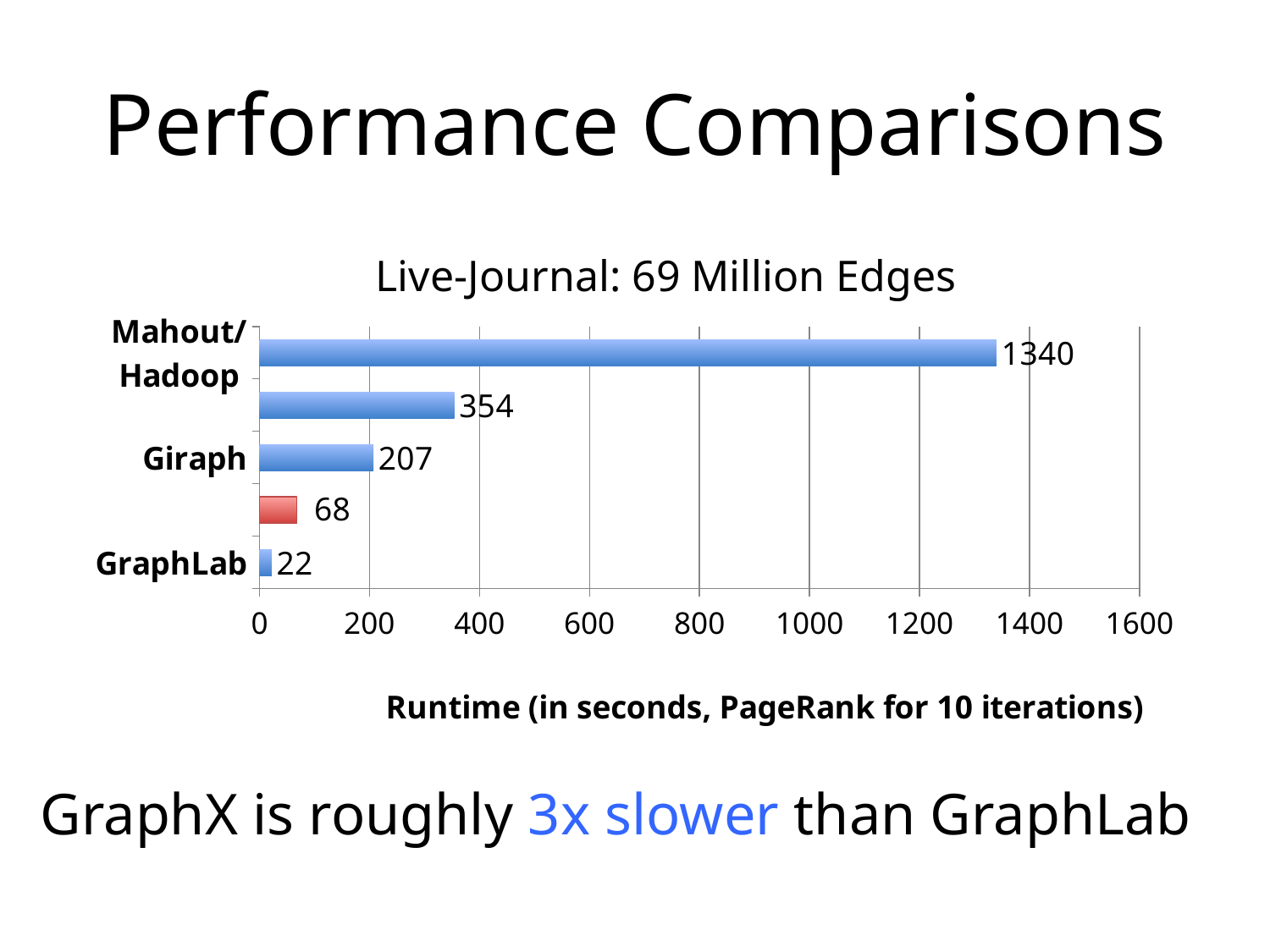
What kind of chart is shown on the slide? bar chart What is the difference in runtime between Giraph and GraphLab? 185 What is the difference in runtime between Mahout/Hadoop and Giraph? 1133 How many bars are plotted in the chart? 5 What is the runtime for Mahout/Hadoop? 1340 Which has a larger runtime, Giraph or GraphLab? Giraph What is the title of the chart? Live-Journal: 69 Million Edges Is the runtime for Mahout/Hadoop greater or less than 1200? greater What is the runtime for GraphLab? 22 Which labelled system has the highest runtime? Mahout/Hadoop What is the runtime for Giraph? 207 Which labelled system has the lowest runtime? GraphLab